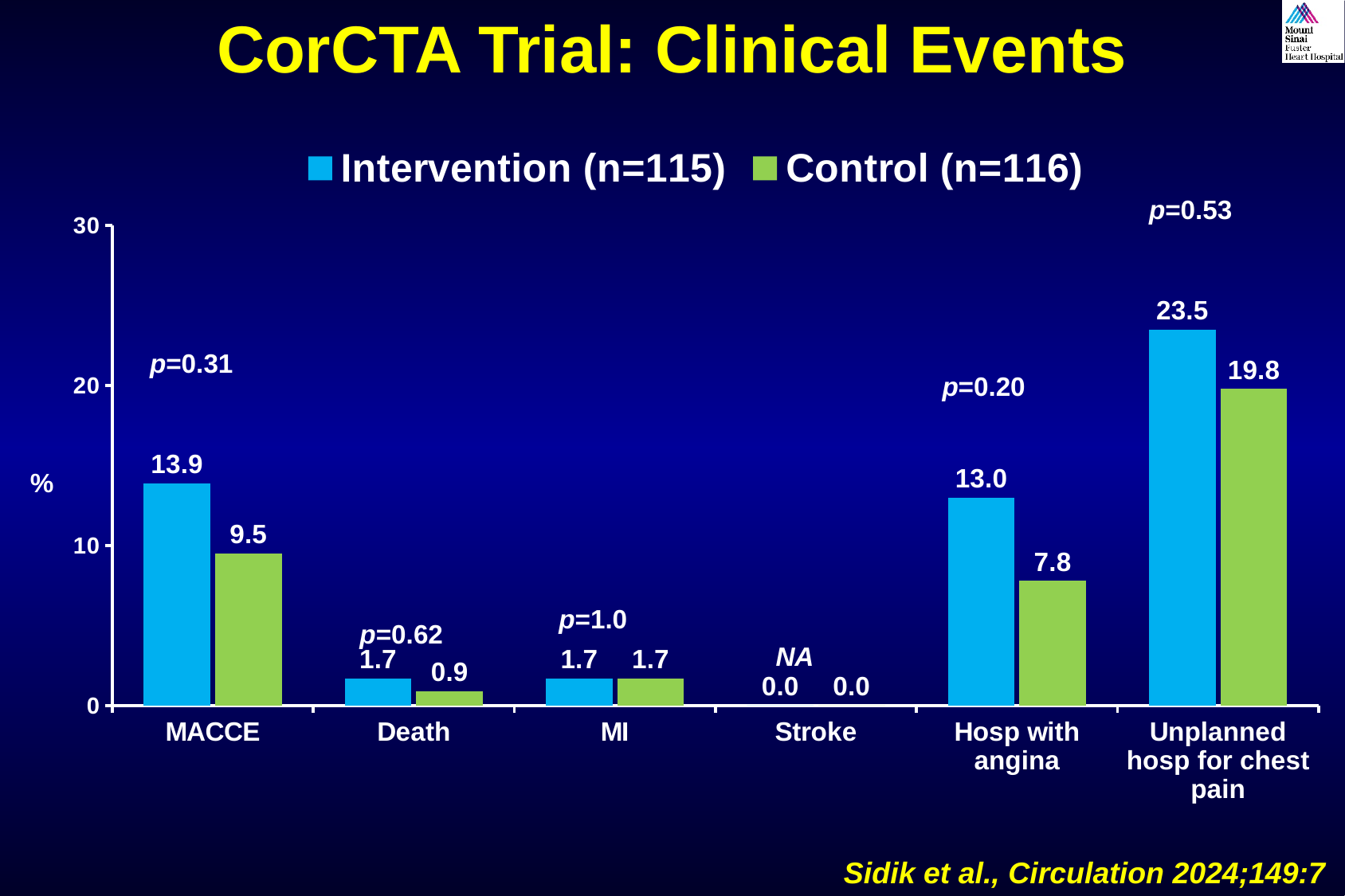
What p-value is shown above the Unplanned hosp for chest pain bars? p=0.53 What is the value for Intervention (n=115) for MACCE? 13.9 What kind of chart is shown on the slide? Bar chart Which category has the lowest value for Control (n=116)? Stroke Which is larger for Death: the Intervention (n=115) value or the Control (n=116) value? Intervention (n=115) What is the value for Control (n=116) for Unplanned hosp for chest pain? 19.8 What is the value for Control (n=116) for Hosp with angina? 7.8 How many series does the legend list? 2 How many categories are shown on the x axis? 6 Which category has the highest value for Intervention (n=115)? Unplanned hosp for chest pain What is the difference between the Intervention (n=115) and Control (n=116) values for MACCE? 4.4 What is the difference between the Intervention (n=115) and Control (n=116) values for Hosp with angina? 5.2